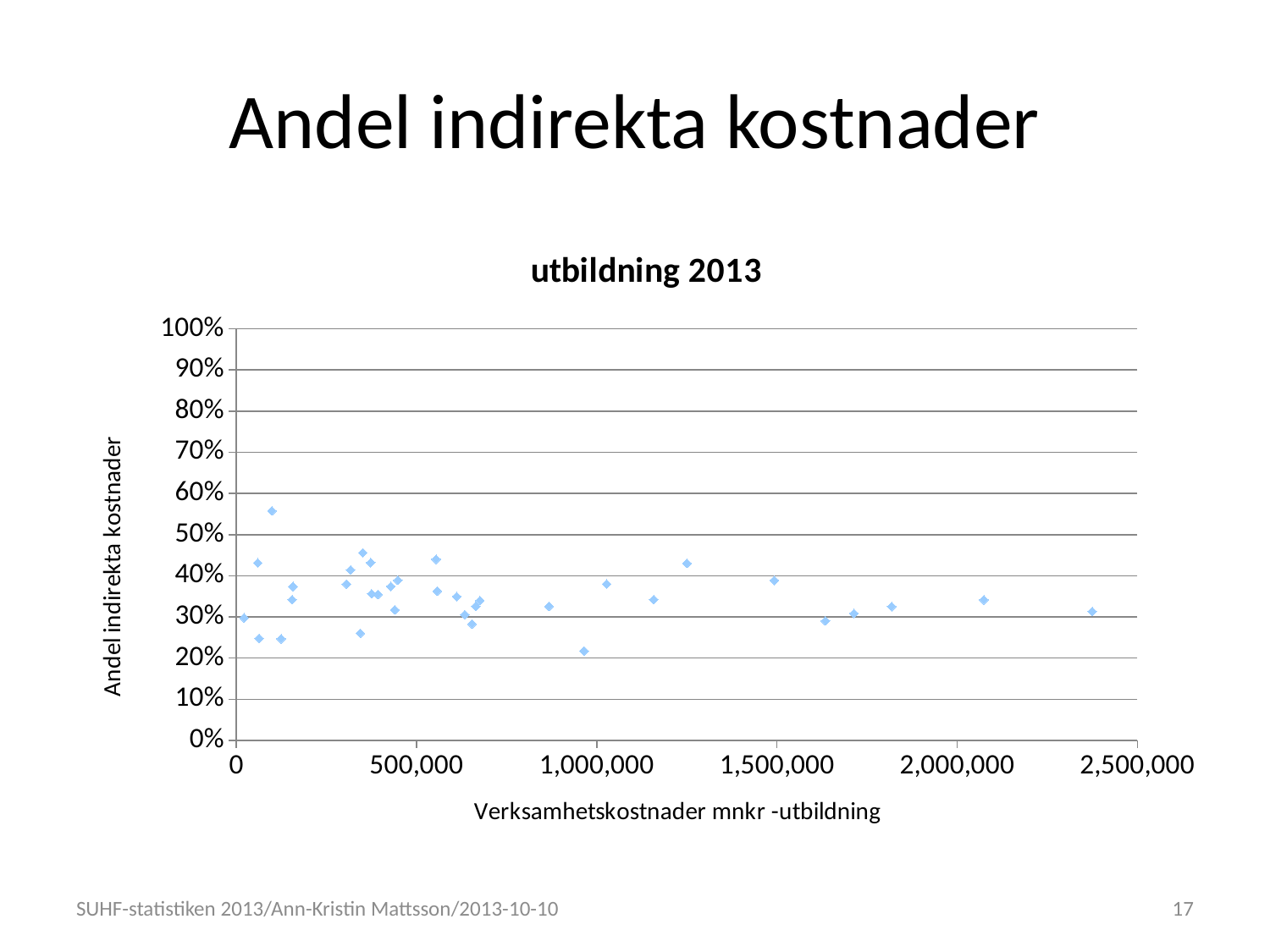
What is the title of the chart? utbildning 2013 Is the lowest point on the chart greater or less than 30%? less What is the maximum value shown on the vertical axis? 100% What kind of chart is shown on the slide? scatter chart Which is larger: the highest point near 100,000 on the x axis or the point near 1,500,000? the point near 100,000 Is the value for the rightmost point (near 2,400,000) greater or less than 40%? less What is the label of the vertical axis? Andel indirekta kostnader Is the value for the point at roughly 1,250,000 on the x axis greater or less than 40%? greater